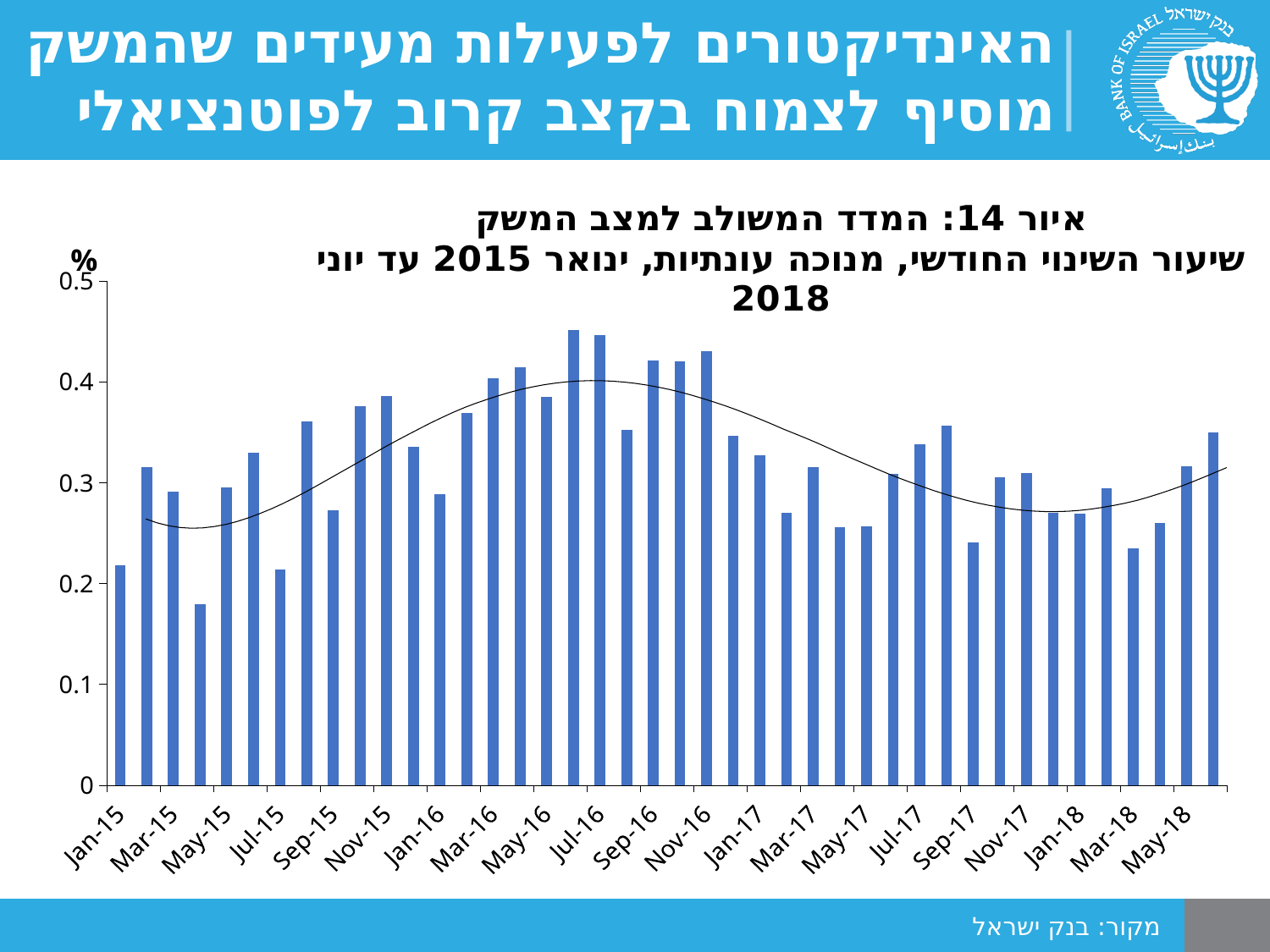
Which is larger, the value for Jul-16 or the value for Jan-17? Jul-16 Which is larger, the value for Jan-15 or the value for Mar-15? Mar-15 Is the value for Apr-15 greater or less than 0.2? less Is the value for Sep-17 greater or less than 0.3? less What is the figure number given in the chart title? 14 Is the value for Jan-15 greater or less than 0.3? less What unit is shown at the top of the vertical axis? % Which month has the lowest value in the chart? Apr-15 What kind of chart is shown on the slide? bar chart